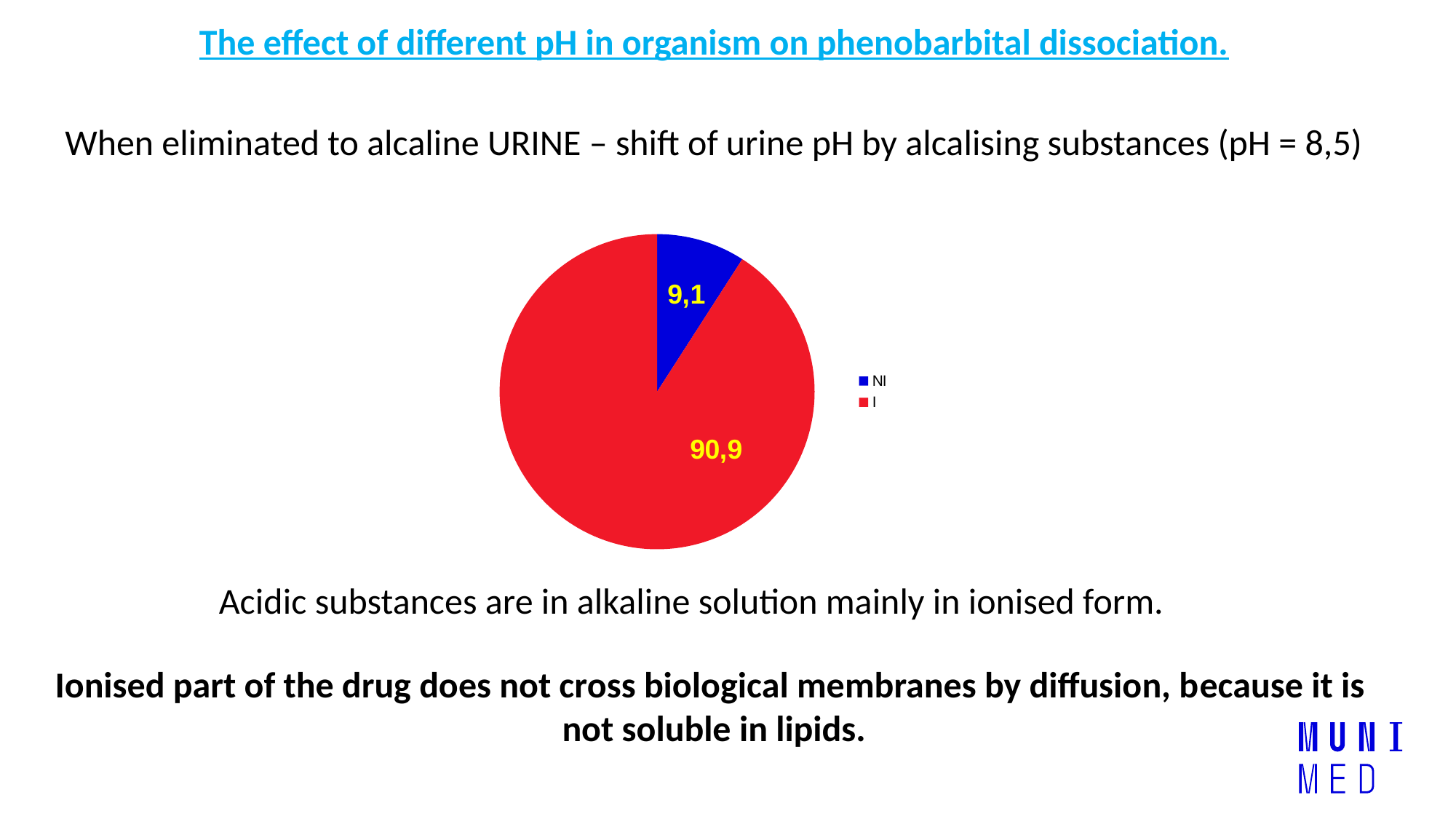
Which slice of the pie chart is the largest? I What is the difference between the I value and the NI value in the pie chart? 81,8 How many entries does the legend of the pie chart list? 2 What colour is the I slice in the pie chart? red Which slice of the pie chart is the smallest? NI What kind of chart is shown on the slide? pie chart What is the value shown for the I slice of the pie chart? 90,9 What colour is the NI slice in the pie chart? blue How many slices does the pie chart have? 2 What is the value shown for the NI slice of the pie chart? 9,1 Which is larger in the pie chart, NI or I? I